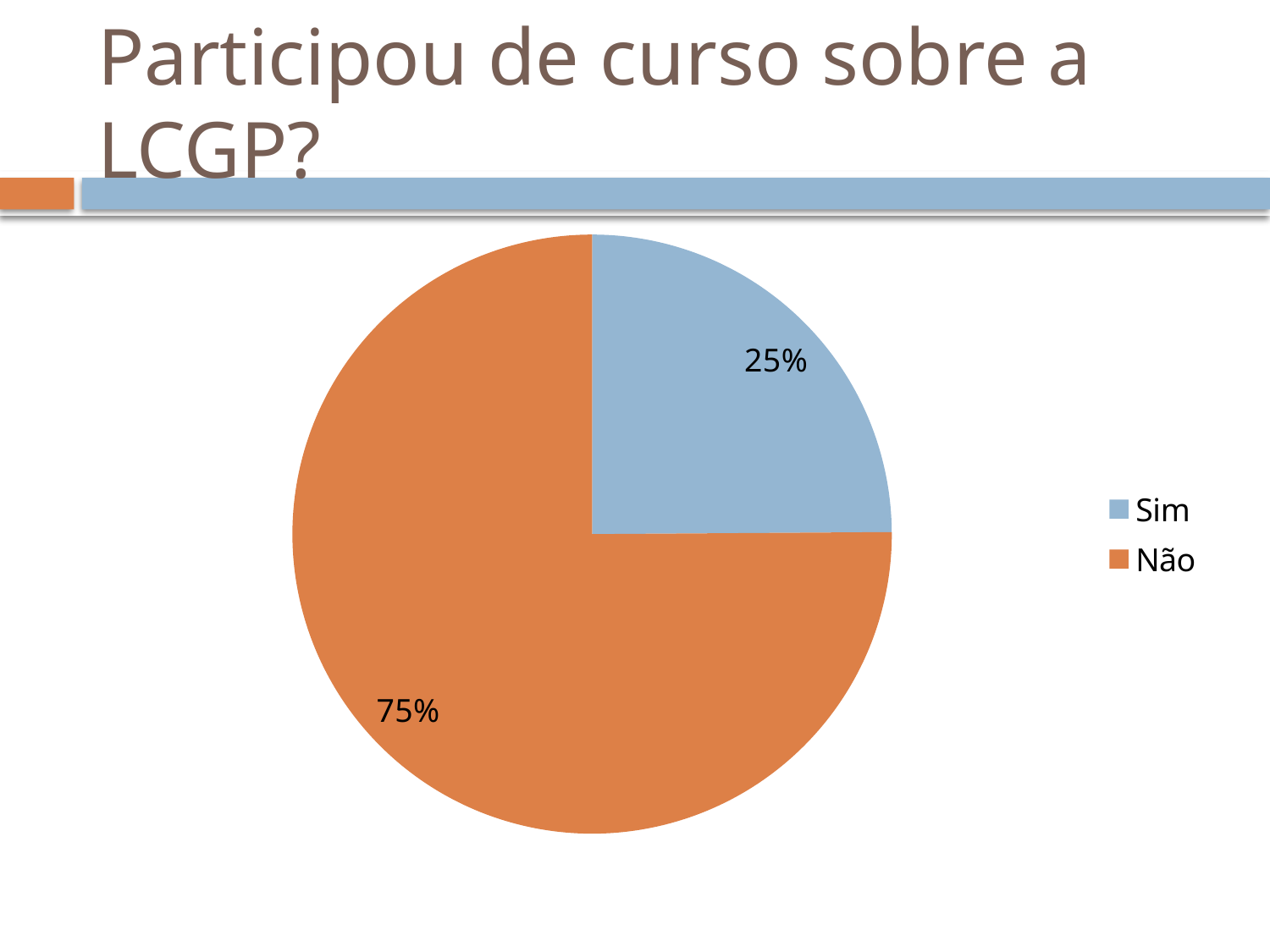
What share of the pie does the "Sim" slice represent? 25% Which category has the largest slice of the pie? Não How many slices does the pie chart have? 2 What is the title of the slide containing the pie chart? Participou de curso sobre a LCGP? What is the difference in percentage points between the "Não" slice and the "Sim" slice? 50 What percentage of the pie is labelled for "Sim"? 25% How many entries does the legend list? 2 Which category has the smallest slice of the pie? Sim What kind of chart is shown on the slide? pie chart What colour is the "Não" slice? orange What percentage of the pie is labelled for "Não"? 75% Which slice is larger, "Sim" or "Não"? Não